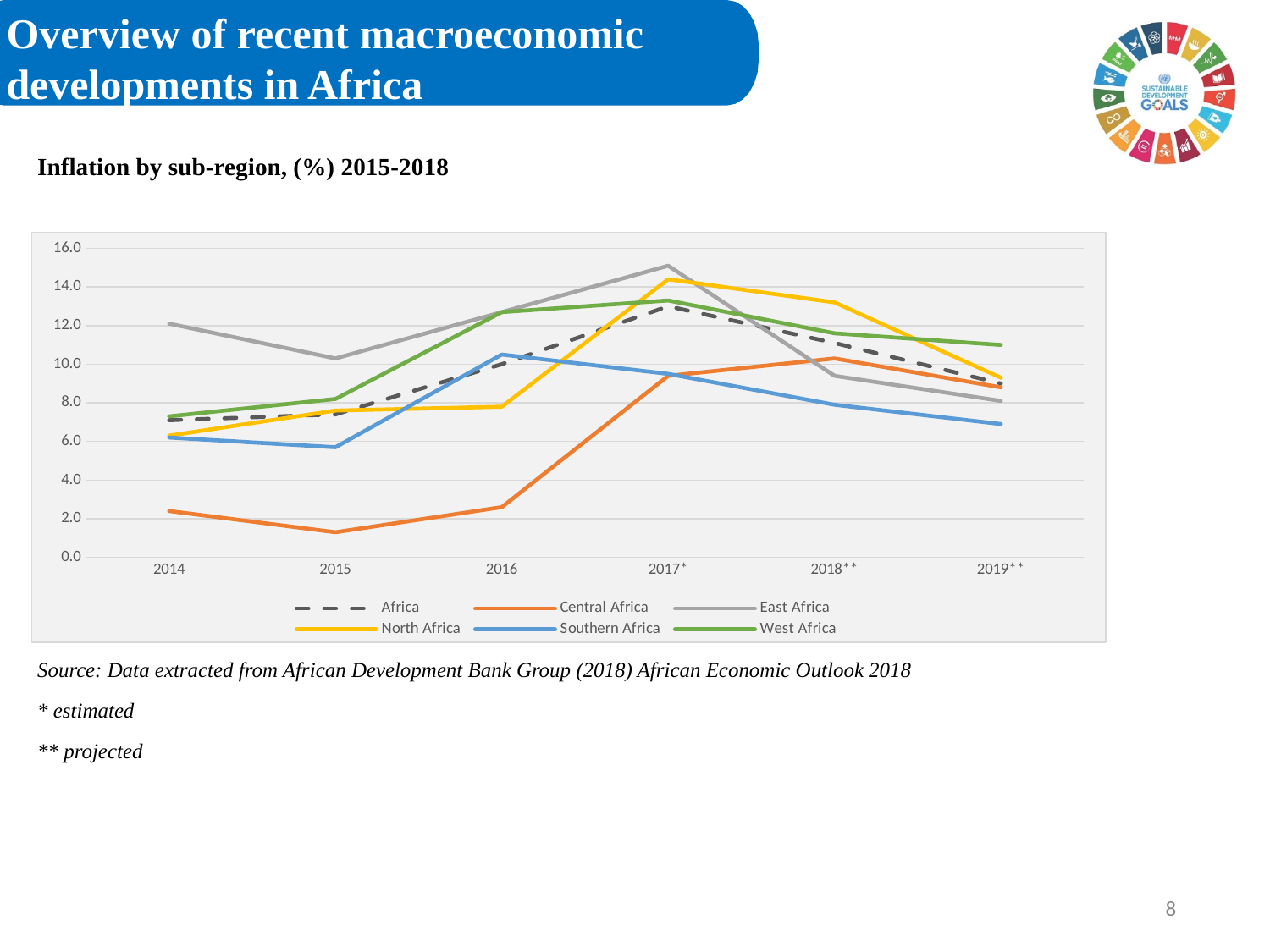
Is the value for Central Africa in 2015 greater or less than 2.0? less Which sub-region has the lowest inflation in 2015? Central Africa Is the value for North Africa in 2018** greater or less than 12.0? greater Which sub-region has the highest inflation in 2017*? East Africa In 2014, which is larger: the value for East Africa or the value for Central Africa? East Africa How many series does the legend list? 6 What kind of chart is shown on the slide? line chart Is the value for East Africa in 2017* greater or less than 14.0? greater Which sub-region has the highest inflation in 2019**? West Africa How many years are shown along the x axis? 6 Which series is drawn with a dashed line? Africa Does the Southern Africa line rise or fall from 2016 to 2019**? fall